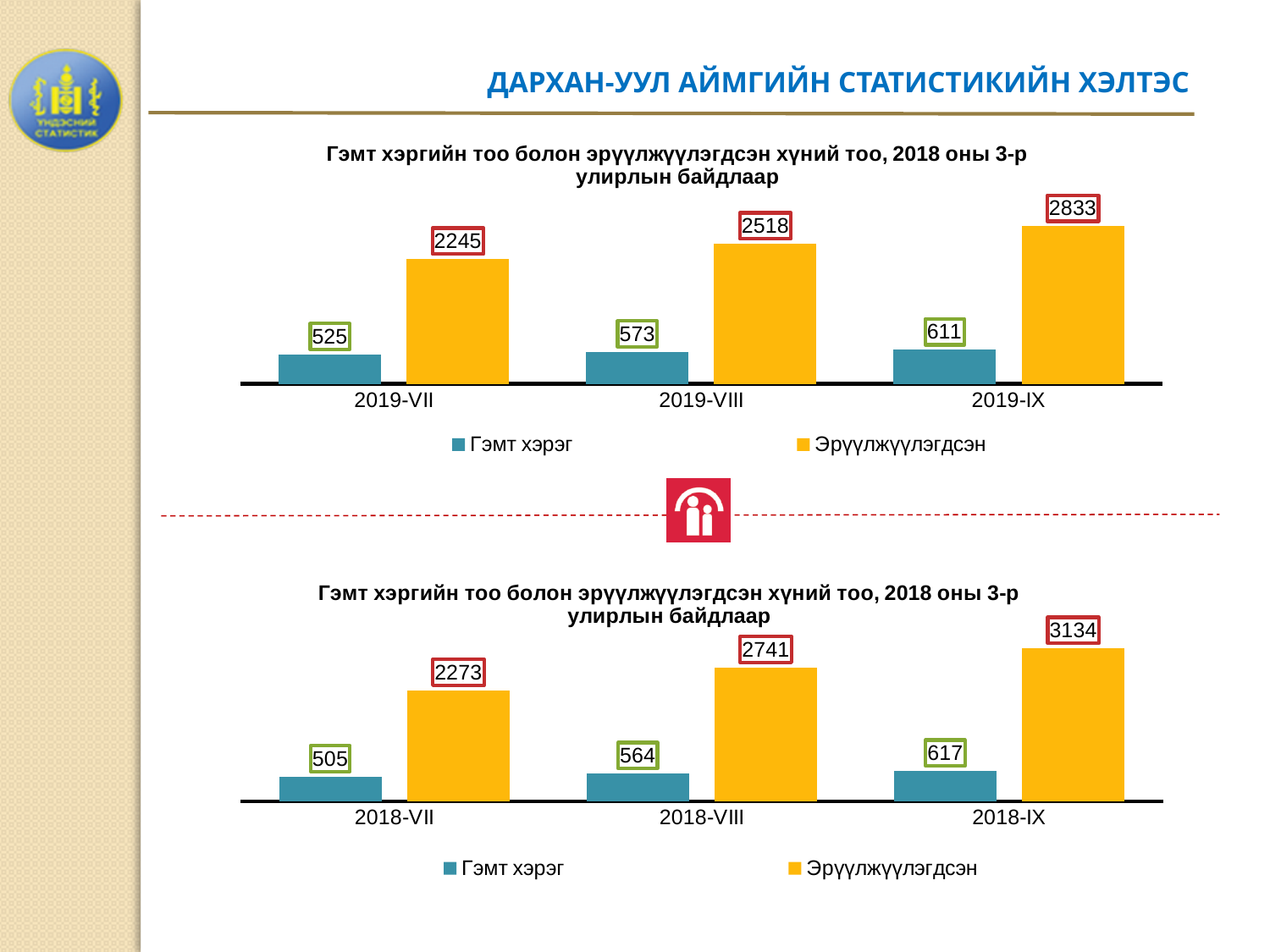
How many months are shown on the x axis of the top chart? 3 In the top chart, which month has the highest value of Эрүүлжүүлэгдсэн? 2019-IX In the bottom chart, what is the difference in Эрүүлжүүлэгдсэн between 2018-IX and 2018-VII? 861 In the top chart, what is the value of Эрүүлжүүлэгдсэн for 2019-IX? 2833 In the top chart, what is the difference between Эрүүлжүүлэгдсэн and Гэмт хэрэг for 2019-VIII? 1945 In the top chart, what is the value of Гэмт хэрэг for 2019-VII? 525 In the bottom chart, what is the value of Эрүүлжүүлэгдсэн for 2018-VIII? 2741 In the top chart, do the Гэмт хэрэг values rise or fall from 2019-VII to 2019-IX? rise In the bottom chart, what is the value of Гэмт хэрэг for 2018-IX? 617 How many series does the legend of the bottom chart list? 2 In the bottom chart, which is larger: Гэмт хэрэг for 2018-VIII or Гэмт хэрэг for 2018-IX? 2018-IX In the bottom chart, which month has the lowest value of Гэмт хэрэг? 2018-VII